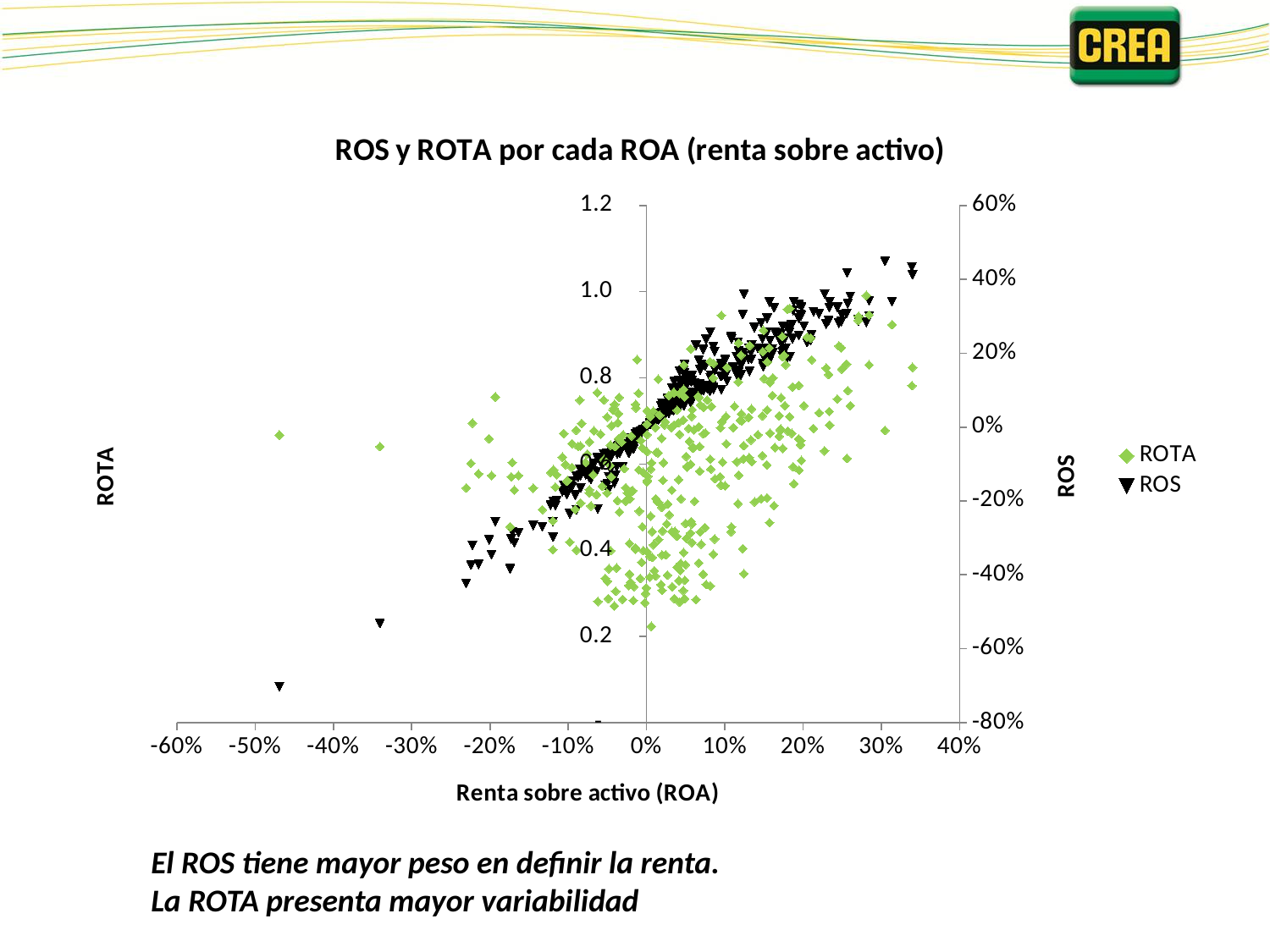
What kind of chart is shown on the slide? Scatter chart What are the two series named in the legend? ROTA and ROS Do the ROS values rise or fall as ROA increases along the x axis? Rise Are the ROS values plotted at around 30% ROA greater or less than 20%? greater How many series does the legend list? 2 Are the ROS values plotted at around -20% ROA greater or less than 0%? less Which series, ROTA or ROS, shows more scatter around the trend? ROTA What is the title of the chart? ROS y ROTA por cada ROA (renta sobre activo)